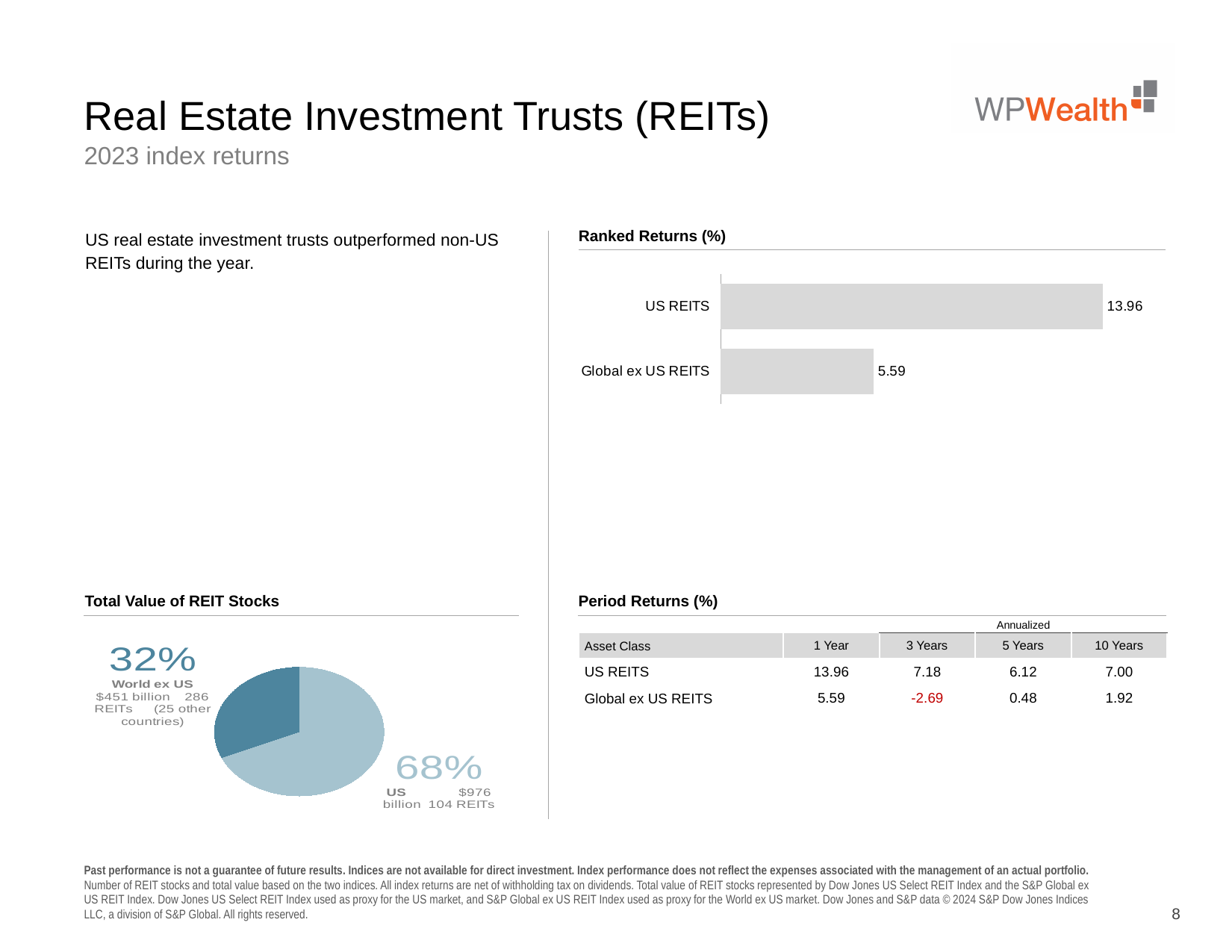
In the Ranked Returns (%) chart, what is the difference between the US REITS and Global ex US REITS values? 8.37 In the Ranked Returns (%) chart, which category has the highest value? US REITS In the Ranked Returns (%) chart, which category has the lowest value? Global ex US REITS What kind of chart is the Total Value of REIT Stocks chart? Pie chart In the Ranked Returns (%) chart, which is larger: US REITS or Global ex US REITS? US REITS How many categories are shown in the Ranked Returns (%) chart? 2 What kind of chart is the Ranked Returns (%) chart? Bar chart In the Total Value of REIT Stocks pie chart, what share does the US slice represent? 68% In the Total Value of REIT Stocks pie chart, what share does the World ex US slice represent? 32% In the Ranked Returns (%) chart, what is the value for Global ex US REITS? 5.59 In the Total Value of REIT Stocks pie chart, which slice is larger: US or World ex US? US In the Ranked Returns (%) chart, what is the value for US REITS? 13.96